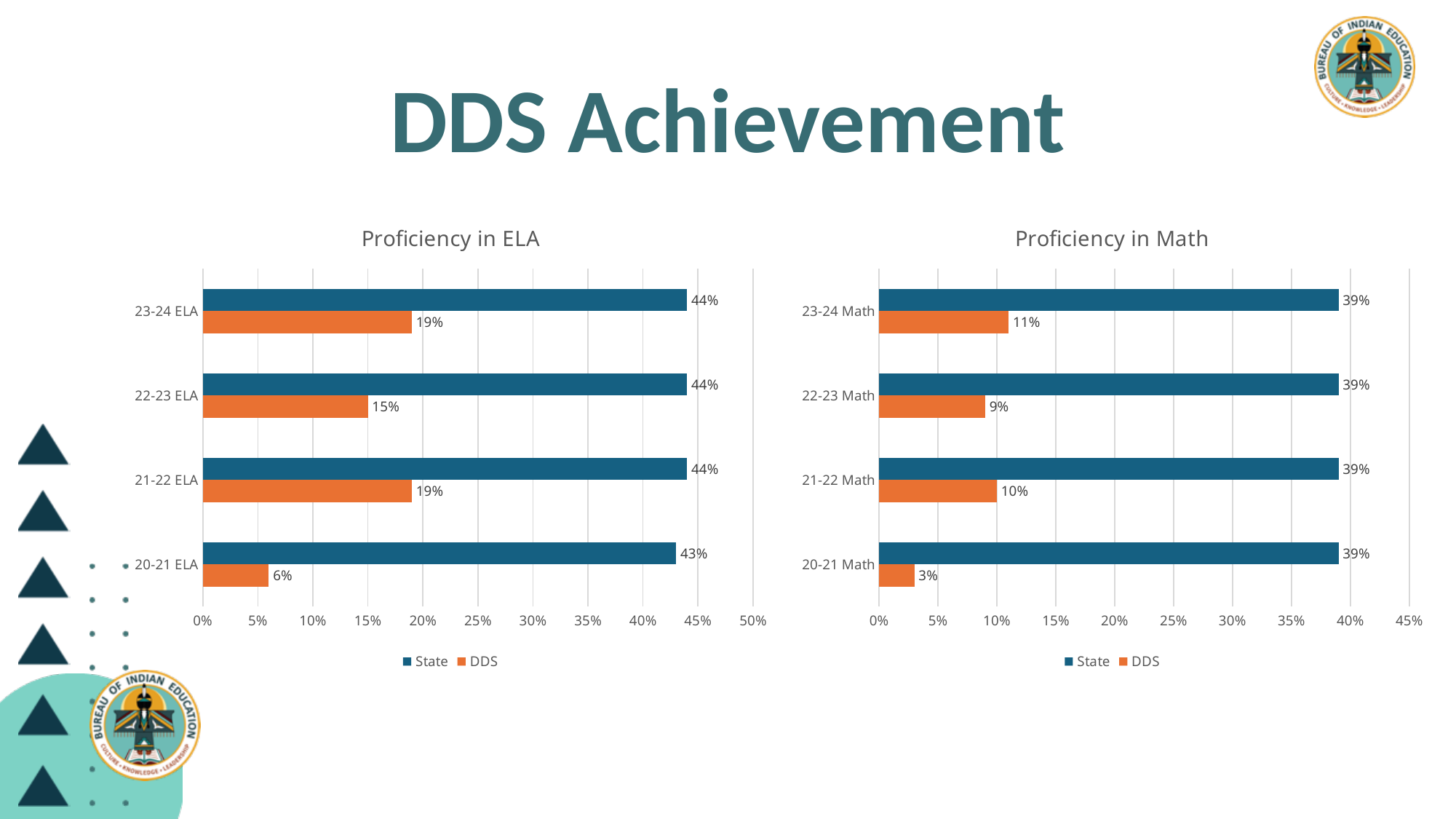
What kind of chart is the Proficiency in Math chart? Bar chart In the Proficiency in ELA chart, which category has the lowest DDS value? 20-21 ELA In the Proficiency in Math chart, which is larger, the DDS value for 22-23 Math or for 21-22 Math? 21-22 Math In the Proficiency in Math chart, what is the State value for 21-22 Math? 39% In the Proficiency in Math chart, what is the DDS value for 23-24 Math? 11% How many categories are shown in the Proficiency in ELA chart? 4 In the Proficiency in ELA chart, what is the DDS value for 22-23 ELA? 15% In the Proficiency in Math chart, which category has the lowest DDS value? 20-21 Math In the Proficiency in ELA chart, what is the difference between the State and DDS values for 23-24 ELA? 25% In the Proficiency in ELA chart, what is the State value for 20-21 ELA? 43% In the Proficiency in Math chart, what is the difference between the DDS values for 23-24 Math and 20-21 Math? 8% How many series does the legend of the Proficiency in Math chart list? 2